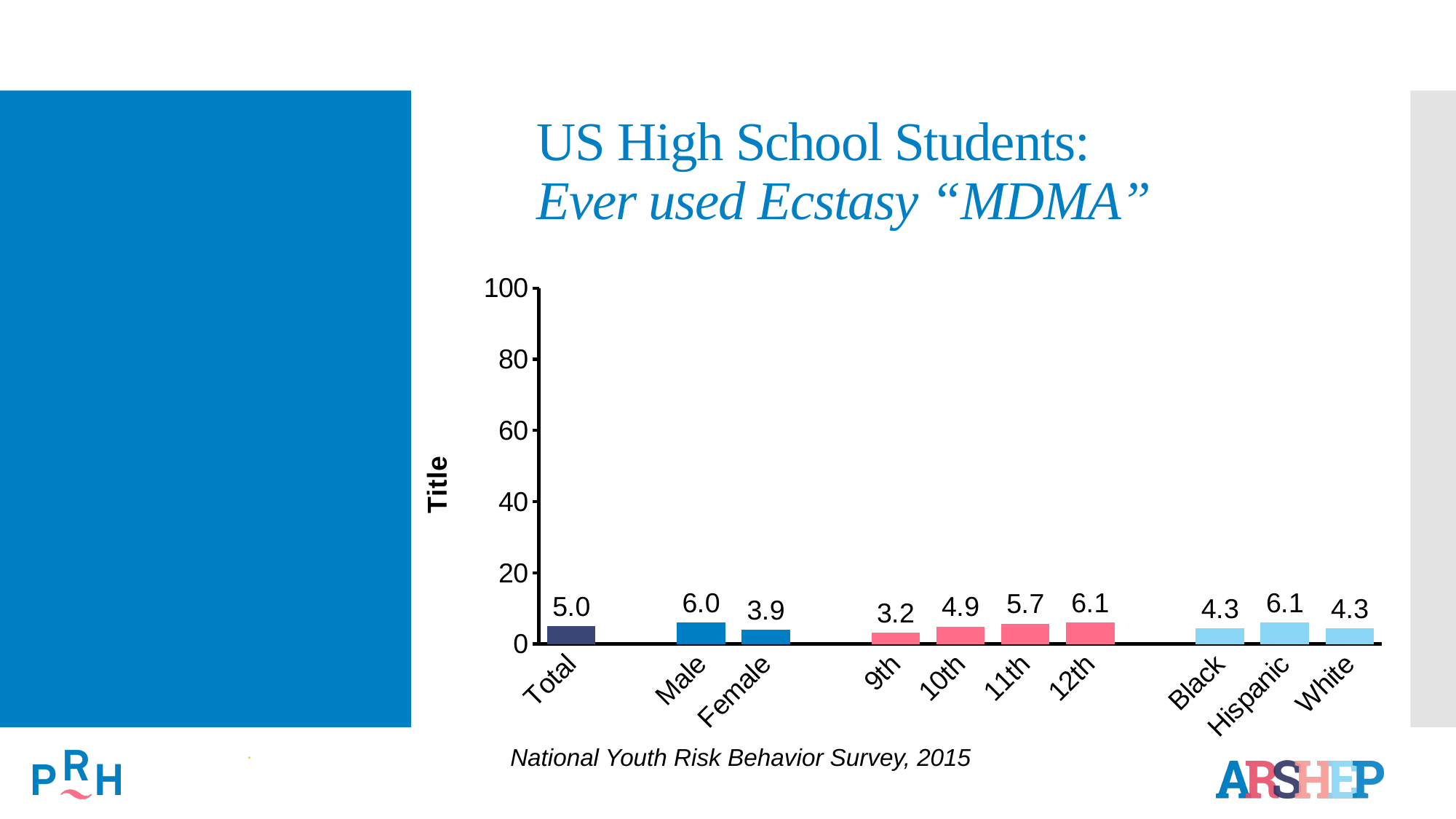
How many categories are shown on the x axis? 10 What kind of chart is shown on the slide? bar chart Which category has the lowest value? 9th What is the difference between the values for Male and Female? 2.1 What is the value for Hispanic students? 6.1 What is the difference between the values for 12th grade and 9th grade? 2.9 Among the grade levels (9th, 10th, 11th, 12th), which has the highest value? 12th What is the value for 10th grade? 4.9 Is the value for Male greater or less than 20? less What is the value for Female? 3.9 What is the value for Total? 5.0 Which is larger, the value for Black or the value for Hispanic? Hispanic